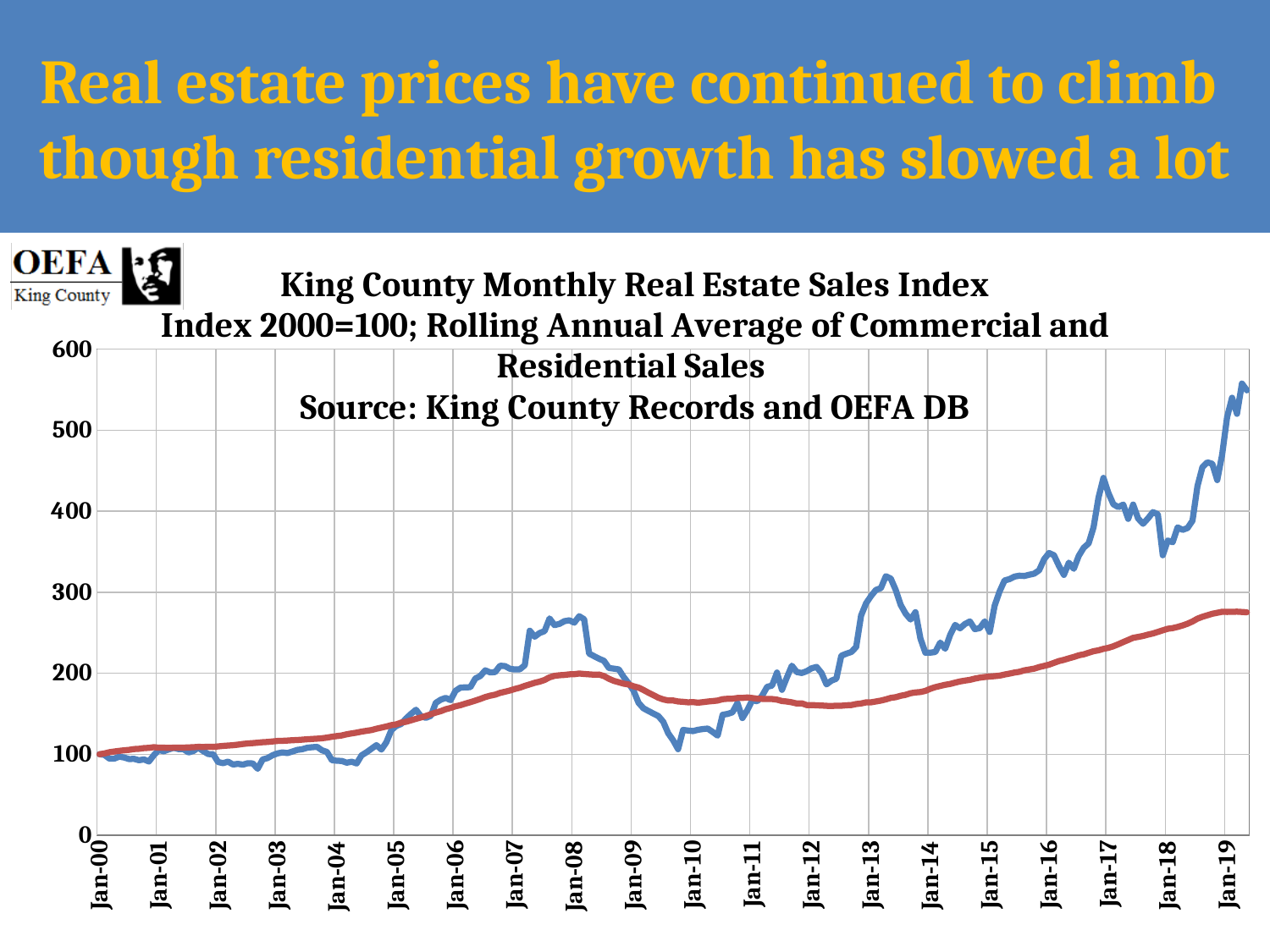
Is the value of the blue line at Jan-19 greater or less than 500? greater What is the highest value shown on the vertical axis? 600 What is the title of the chart? King County Monthly Real Estate Sales Index Is the value of the blue line at Jan-10 greater or less than 200? less How many year labels are shown along the x axis, from Jan-00 to Jan-19? 20 What kind of chart is shown on the slide? line chart How many lines are plotted on the chart? 2 At Jan-19, which line has the higher value, the blue line or the red line? the blue line Is the value of the blue line at Jan-17 greater or less than 400? greater At Jan-10, which line has the higher value, the blue line or the red line? the red line Does the red line generally rise or fall from Jan-00 to Jan-19? rise